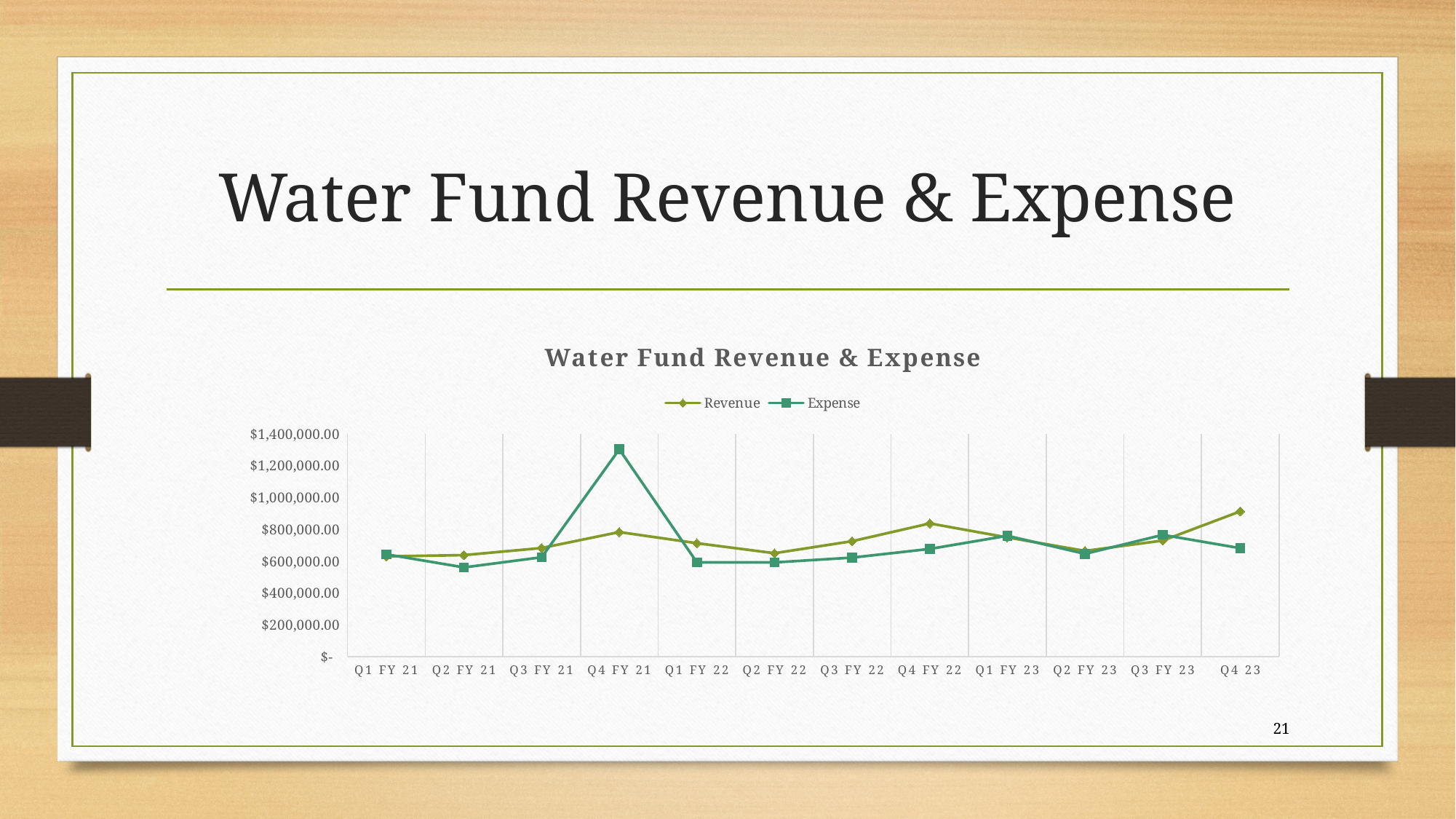
In Q4 23, which is larger, Revenue or Expense? Revenue In which quarter does the Expense series reach its highest value? Q4 FY 21 Is the Revenue value for Q4 23 greater or less than $800,000.00? greater What kind of chart is shown on the slide? line chart In Q4 FY 21, which is larger, Revenue or Expense? Expense Does the Revenue series rise or fall from Q2 FY 23 to Q4 23? rise What is the title of the chart? Water Fund Revenue & Expense In which quarter does the Revenue series reach its highest value? Q4 23 How many quarters are plotted along the x axis? 12 How many series does the legend list? 2 Is the Expense value for Q2 FY 21 greater or less than $600,000.00? less Is the Expense value for Q4 FY 21 greater or less than $1,000,000.00? greater